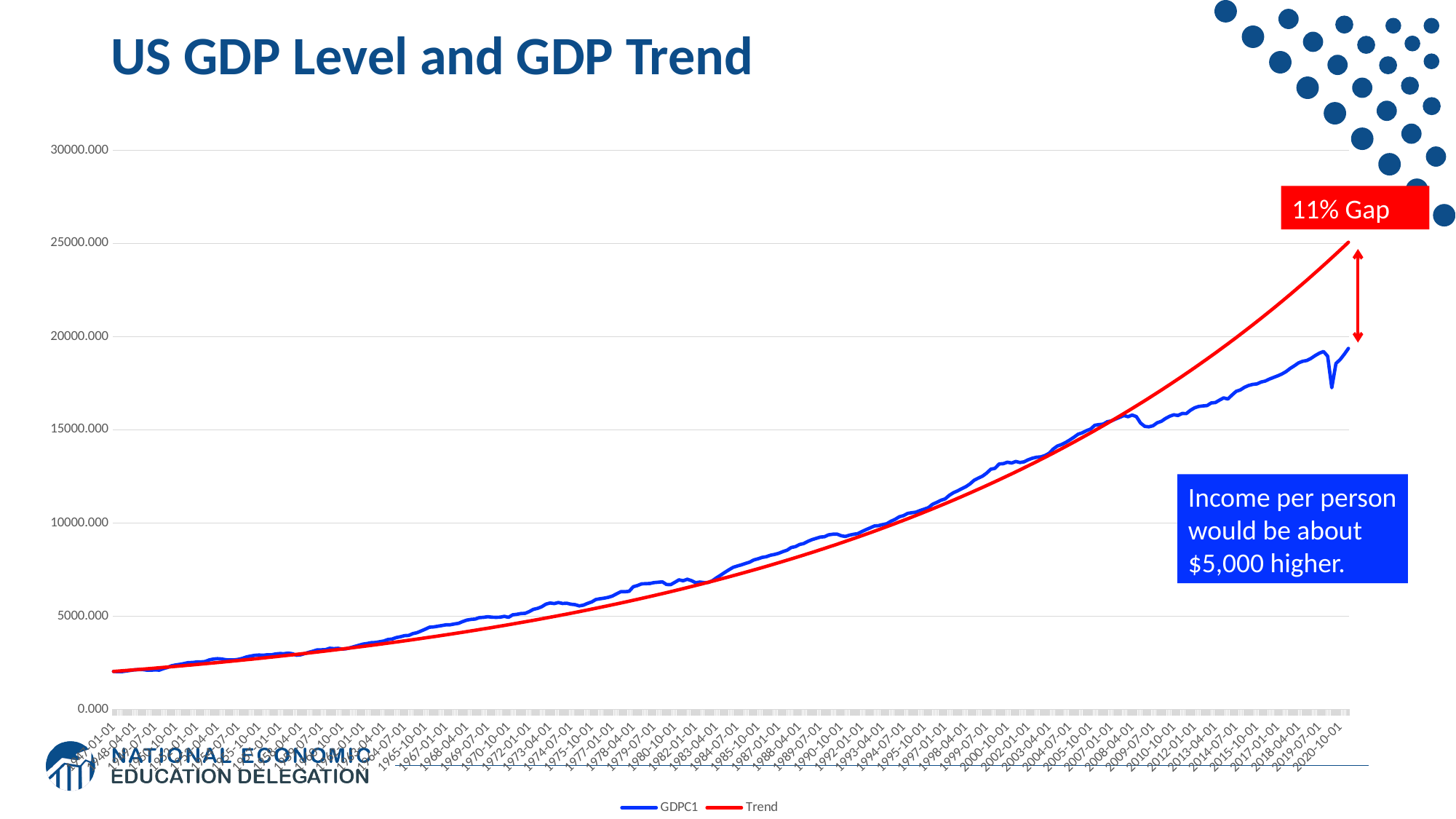
What is the title of the chart? US GDP Level and GDP Trend Is the value of the Trend series at the right end of the chart greater or less than 20000.000? greater What percentage gap between the Trend and GDPC1 lines is labelled on the chart? 11% Gap What is the highest value shown on the y axis? 30000.000 What kind of chart is shown on the slide? line chart Is the value of the GDPC1 series at the right end of the chart greater or less than 20000.000? less Do the GDPC1 values generally rise or fall from left to right along the x axis? rise How many series does the legend list? 2 Is the value of the GDPC1 series at the start of the chart (1947) greater or less than 5000.000? less At the right end of the chart (2020-10-01), which series is higher, GDPC1 or Trend? Trend